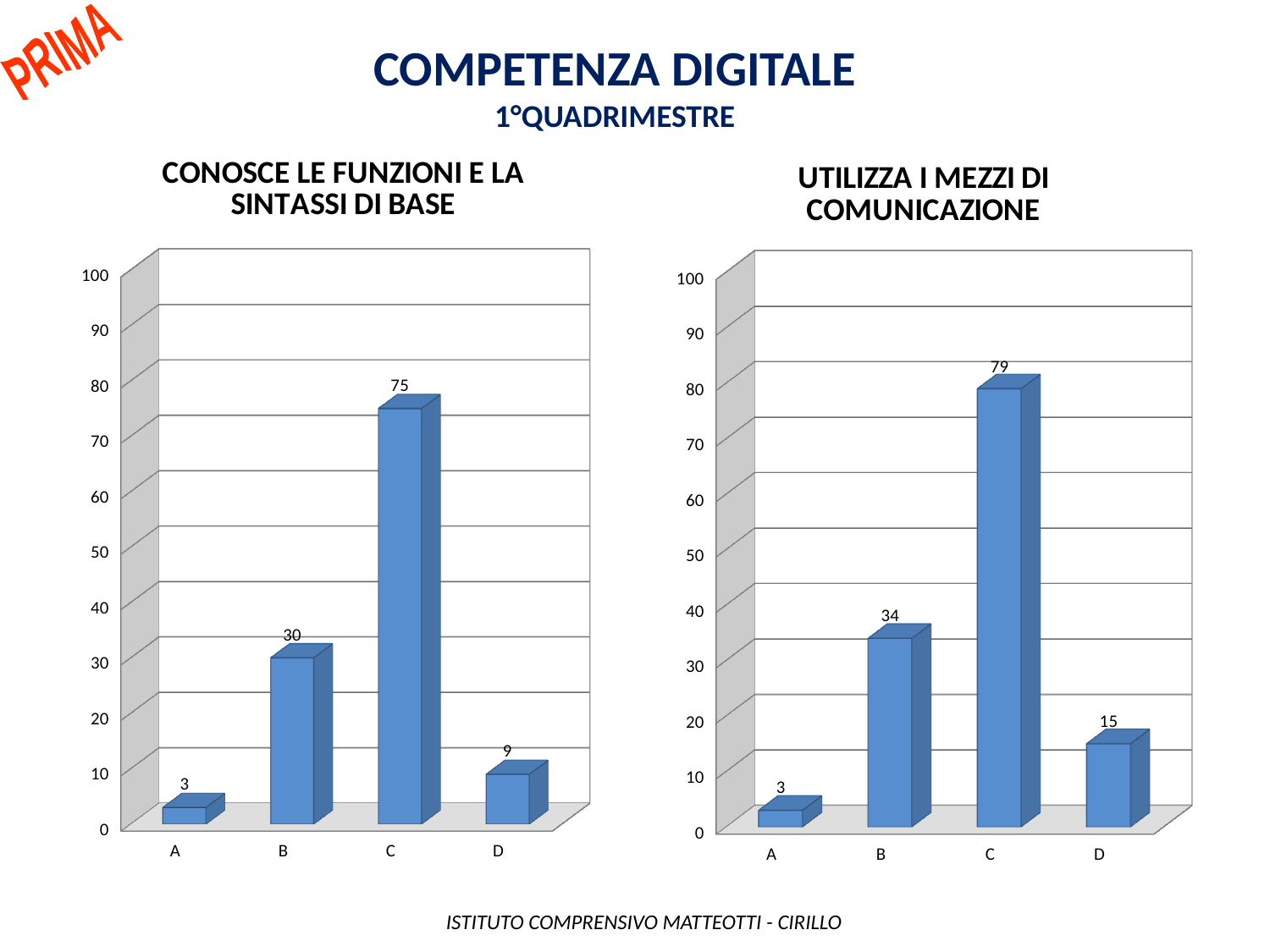
What is the title of the chart on the left of the slide? CONOSCE LE FUNZIONI E LA SINTASSI DI BASE In the chart 'UTILIZZA I MEZZI DI COMUNICAZIONE', what is the value for category D? 15 In the chart 'UTILIZZA I MEZZI DI COMUNICAZIONE', what is the difference between the values for C and D? 64 In the chart 'CONOSCE LE FUNZIONI E LA SINTASSI DI BASE', what is the value for category C? 75 In the chart 'UTILIZZA I MEZZI DI COMUNICAZIONE', what is the value for category B? 34 In the chart 'UTILIZZA I MEZZI DI COMUNICAZIONE', which category has the lowest value? A In the chart 'CONOSCE LE FUNZIONI E LA SINTASSI DI BASE', which is larger, the value for B or the value for D? B In the chart 'UTILIZZA I MEZZI DI COMUNICAZIONE', is the value for C greater or less than 70? greater How many categories are shown in the chart 'CONOSCE LE FUNZIONI E LA SINTASSI DI BASE'? 4 What kind of chart is 'UTILIZZA I MEZZI DI COMUNICAZIONE'? Bar chart In the chart 'CONOSCE LE FUNZIONI E LA SINTASSI DI BASE', what is the difference between the values for C and B? 45 In the chart 'CONOSCE LE FUNZIONI E LA SINTASSI DI BASE', which category has the highest value? C